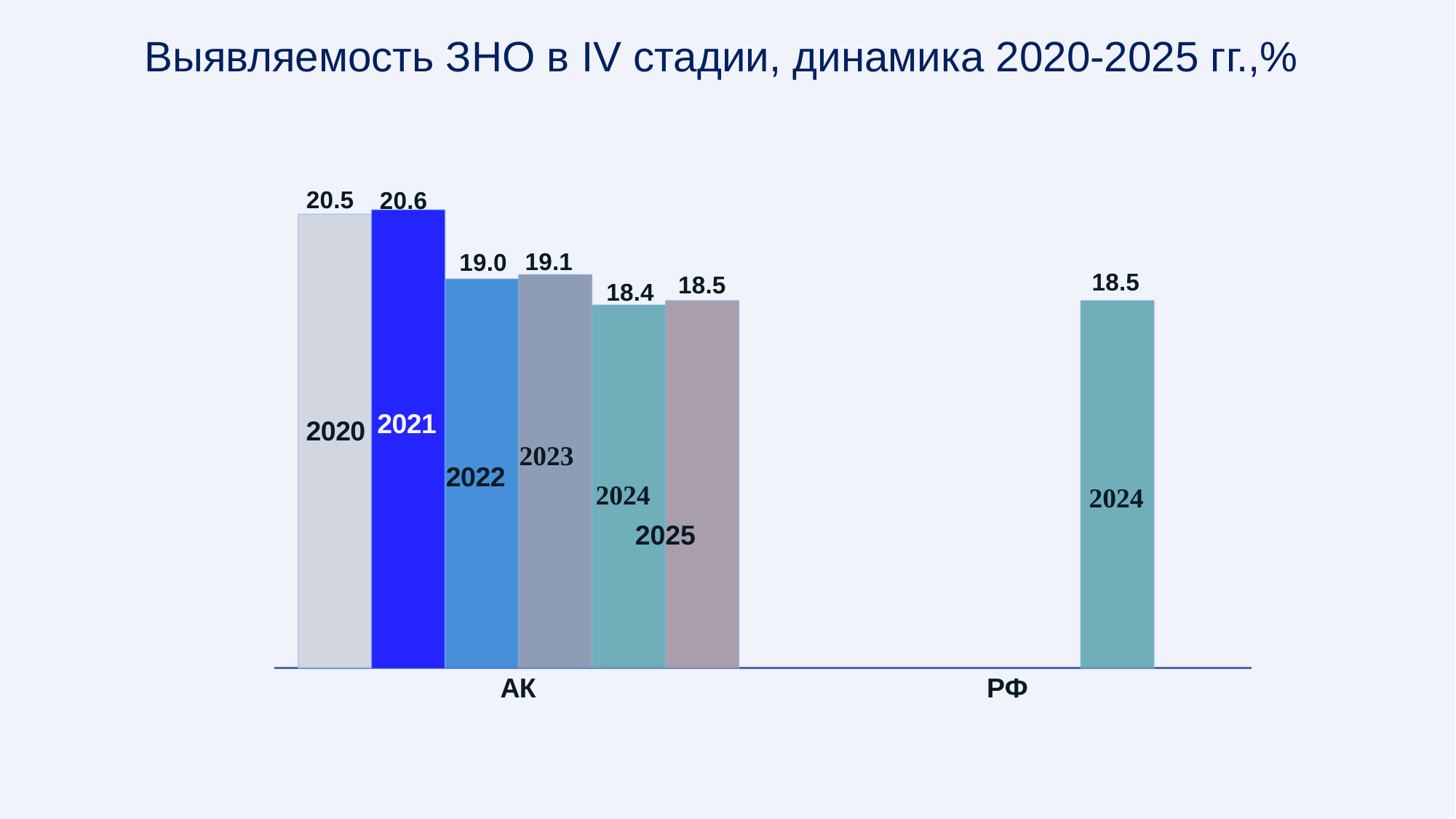
Which year has the lowest value in the АК group? 2024 What is the title of the chart? Выявляемость ЗНО в IV стадии, динамика 2020-2025 гг.,% What is the value for 2020 in the АК group? 20.5 What is the value for 2024 in the РФ group? 18.5 What is the difference between the 2021 and 2025 values in the АК group? 2.1 Which is larger: the 2020 value for АК or the 2023 value for АК? 2020 What is the value for 2022 in the АК group? 19.0 What kind of chart is shown on the slide? Bar chart Which year has the highest value in the АК group? 2021 What is the value for 2021 in the АК group? 20.6 How many bars are shown in the АК group? 6 What is the difference between the 2024 value for АК and the 2024 value for РФ? 0.1